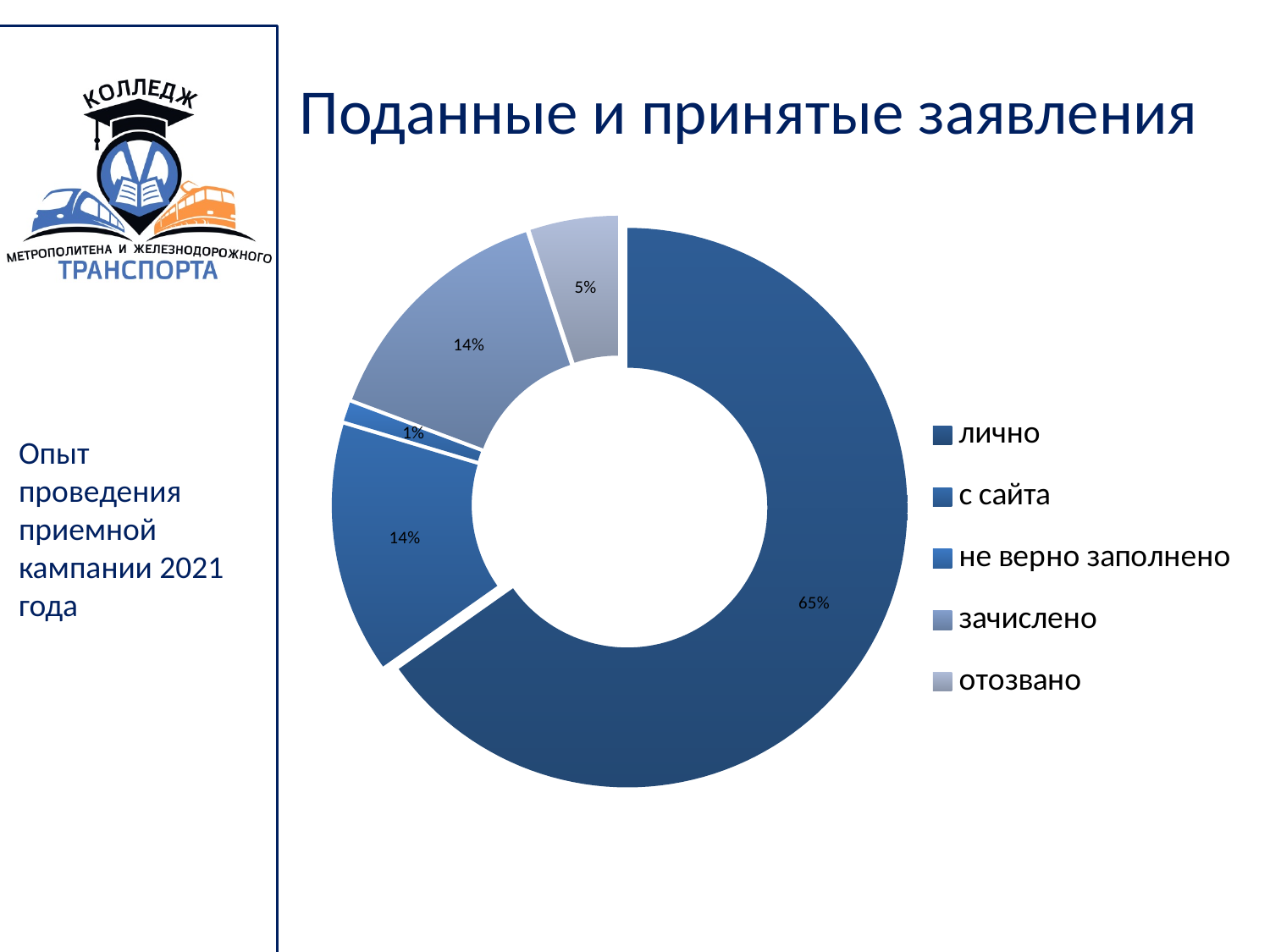
What kind of chart is shown on the slide? Doughnut (pie) chart What percentage is shown for 'зачислено'? 14% What is the title of the chart? Поданные и принятые заявления How many categories does the legend list? 5 What percentage is shown for 'не верно заполнено'? 1% What is the difference in percentage points between 'лично' and 'отозвано'? 60 What share of the chart does the 'лично' slice represent? 65% What percentage is shown for 'с сайта'? 14% Which category has the largest slice? лично Which category has the smallest slice? не верно заполнено Which is larger, the slice for 'отозвано' or the slice for 'не верно заполнено'? отозвано What percentage is shown for 'отозвано'? 5%